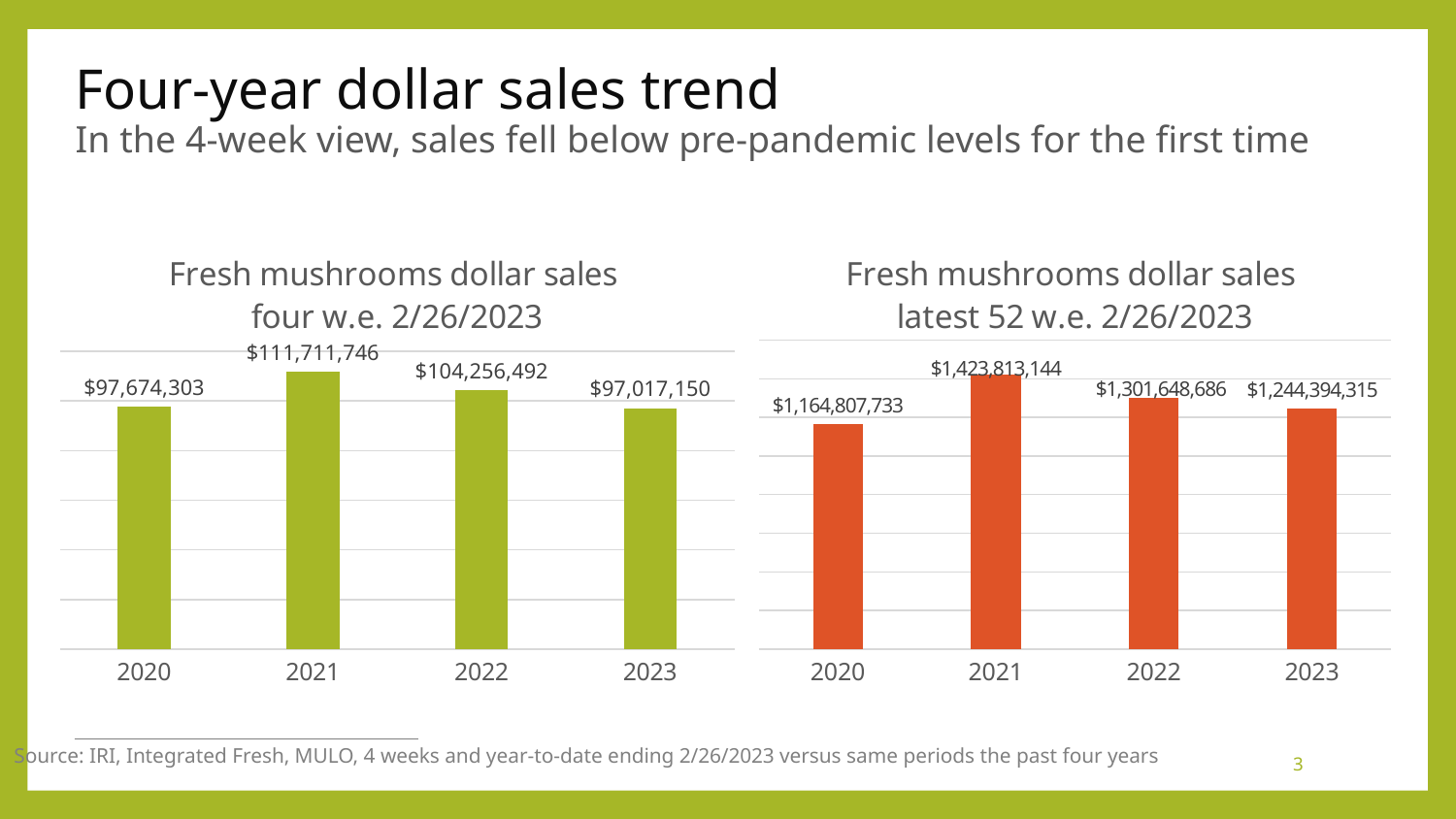
In the 'Fresh mushrooms dollar sales latest 52 w.e. 2/26/2023' chart, what is the value for 2020? $1,164,807,733 In the 'Fresh mushrooms dollar sales latest 52 w.e. 2/26/2023' chart, what is the value for 2022? $1,301,648,686 In the 'Fresh mushrooms dollar sales latest 52 w.e. 2/26/2023' chart, what is the difference between the 2021 and 2020 values? $259,005,411 In the 'Fresh mushrooms dollar sales four w.e. 2/26/2023' chart, which year has the highest value? 2021 In the 'Fresh mushrooms dollar sales latest 52 w.e. 2/26/2023' chart, do the values rise or fall from 2021 to 2023? Fall What kind of chart is the 'Fresh mushrooms dollar sales latest 52 w.e. 2/26/2023' chart? Bar chart In the 'Fresh mushrooms dollar sales four w.e. 2/26/2023' chart, what is the value for 2021? $111,711,746 In the 'Fresh mushrooms dollar sales four w.e. 2/26/2023' chart, what is the value for 2023? $97,017,150 In the 'Fresh mushrooms dollar sales latest 52 w.e. 2/26/2023' chart, which is larger, the value for 2022 or the value for 2023? 2022 In the 'Fresh mushrooms dollar sales four w.e. 2/26/2023' chart, what is the difference between the 2021 and 2022 values? $7,455,254 In the 'Fresh mushrooms dollar sales latest 52 w.e. 2/26/2023' chart, which year has the lowest value? 2020 How many years are shown in the 'Fresh mushrooms dollar sales four w.e. 2/26/2023' chart? 4